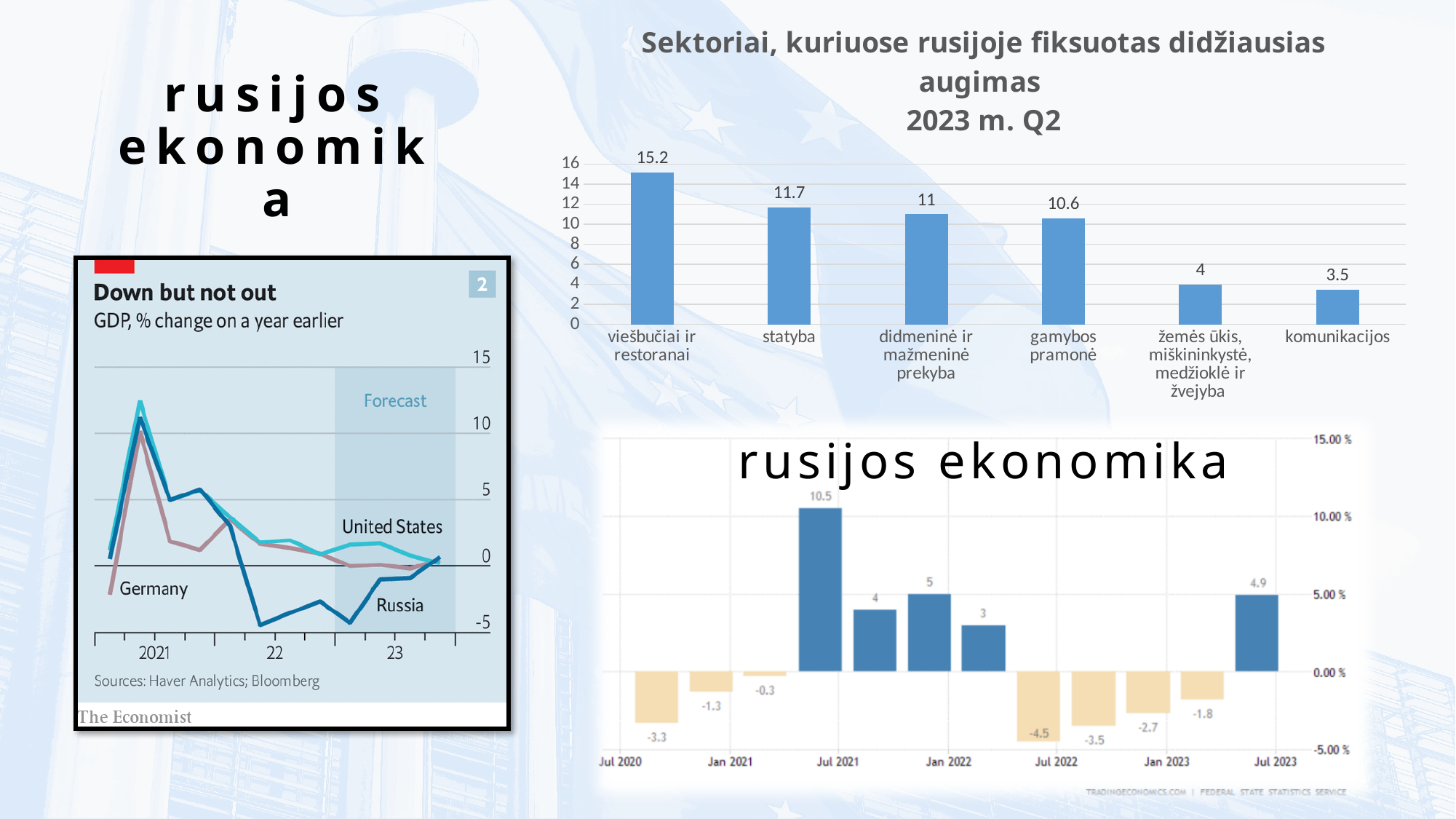
In the chart titled 'Sektoriai, kuriuose rusijoje fiksuotas didžiausias augimas 2023 m. Q2', which sector has the highest value? viešbučiai ir restoranai In the bottom-right chart titled 'rusijos ekonomika', what is the lowest value shown? -4.5 In the bottom-right chart titled 'rusijos ekonomika', what is the value of the last bar, at Jul 2023? 4.9 In the chart titled 'Sektoriai, kuriuose rusijoje fiksuotas didžiausias augimas 2023 m. Q2', what is the difference between the values for viešbučiai ir restoranai and gamybos pramonė? 4.6 In the bottom-right chart titled 'rusijos ekonomika', what is the value for the bar labelled Jul 2021? 10.5 What kind of chart is the bottom-left chart titled 'Down but not out'? line chart In the chart titled 'Sektoriai, kuriuose rusijoje fiksuotas didžiausias augimas 2023 m. Q2', which is larger: didmeninė ir mažmeninė prekyba or žemės ūkis, miškininkystė, medžioklė ir žvejyba? didmeninė ir mažmeninė prekyba In the chart titled 'Sektoriai, kuriuose rusijoje fiksuotas didžiausias augimas 2023 m. Q2', what is the value for statyba? 11.7 In the chart titled 'Sektoriai, kuriuose rusijoje fiksuotas didžiausias augimas 2023 m. Q2', how many sectors are shown? 6 How many countries are plotted in the bottom-left chart titled 'Down but not out'? 3 In the bottom-right chart titled 'rusijos ekonomika', how many bars are plotted? 12 In the chart titled 'Sektoriai, kuriuose rusijoje fiksuotas didžiausias augimas 2023 m. Q2', which sector has the lowest value? komunikacijos